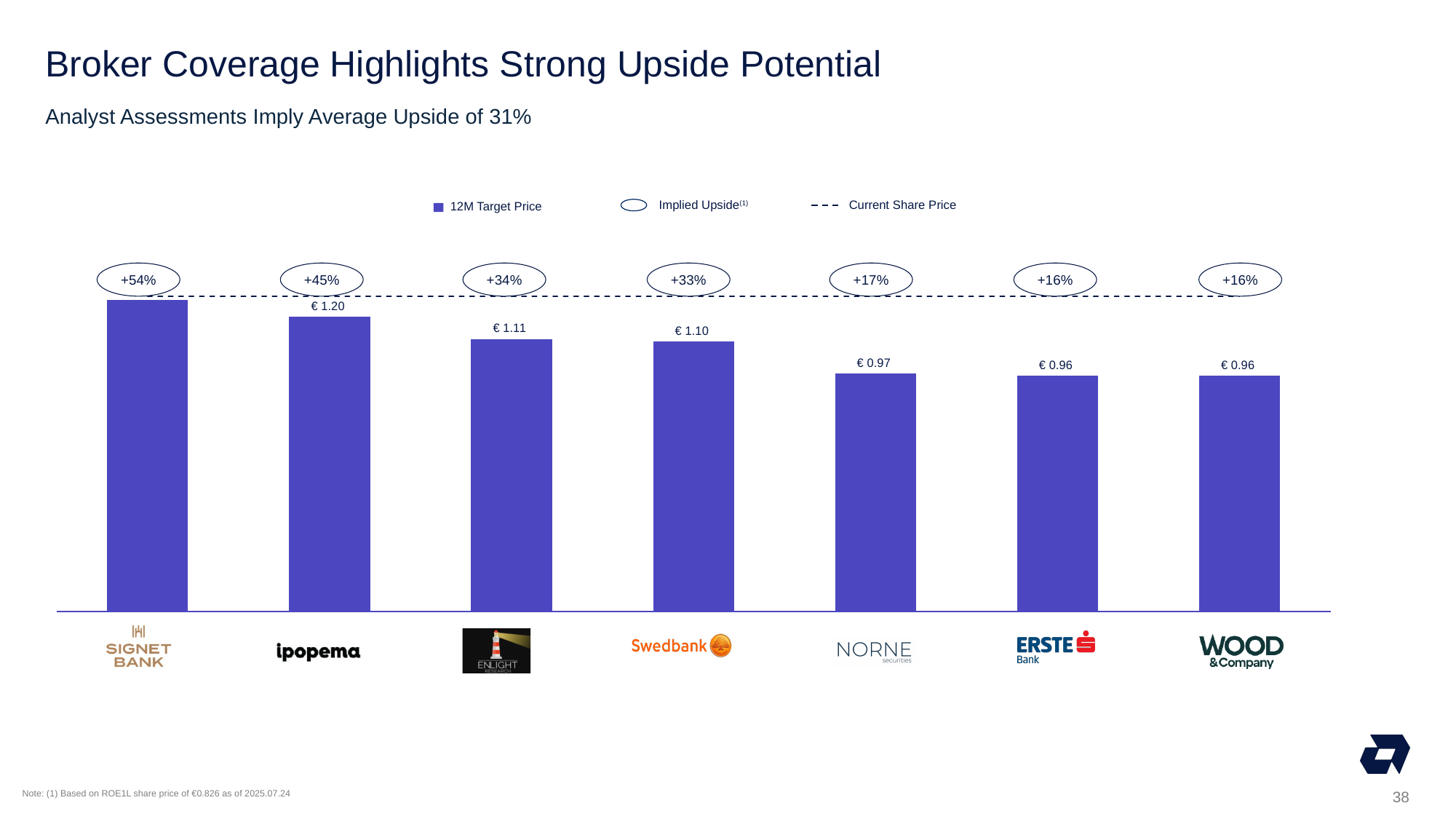
Do the 12M target prices rise or fall from left to right across the chart? Fall How many brokers are shown in the chart? 7 How many entries does the chart legend list? 3 What is the implied upside shown for Norne Securities? +17% What is the implied upside shown for Signet Bank? +54% Which broker has the highest 12M target price? Signet Bank What is the difference between the 12M target prices of Ipopema and Enlight Research? € 0.09 What is the 12M target price from Ipopema? € 1.20 Which broker shows the highest implied upside? Signet Bank What is the 12M target price from Swedbank? € 1.10 Which is larger, the 12M target price from Swedbank or from Norne Securities? Swedbank What kind of chart is shown on the slide? Bar chart